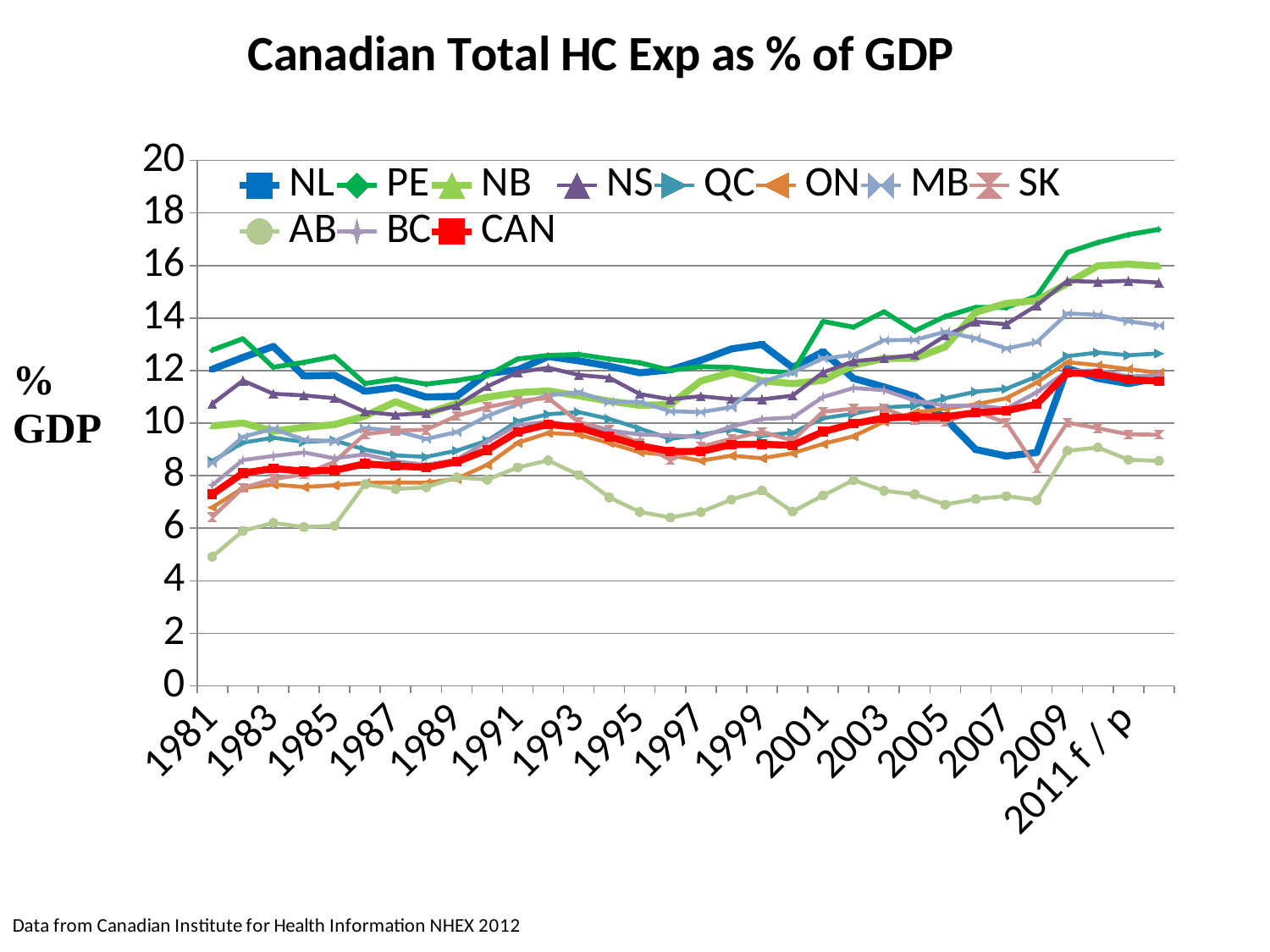
Is the value for CAN in 1981 greater or less than 8? less How many series does the legend list? 11 What is the title of the chart? Canadian Total HC Exp as % of GDP Which series has the lowest value at the last point (2011 f / p)? AB Which series has the lowest value in 1981? AB Is the value for AB in 1981 greater or less than 6? less At the last point (2011 f / p), which is larger, NS or SK? NS Is the value for PE at the last point (2011 f / p) greater or less than 16? greater Which series has the highest value at the last point (2011 f / p)? PE Does the CAN series rise or fall overall from 1981 to 2011 f / p? rise What is the label on the vertical axis? % GDP What kind of chart is shown on the slide? line chart